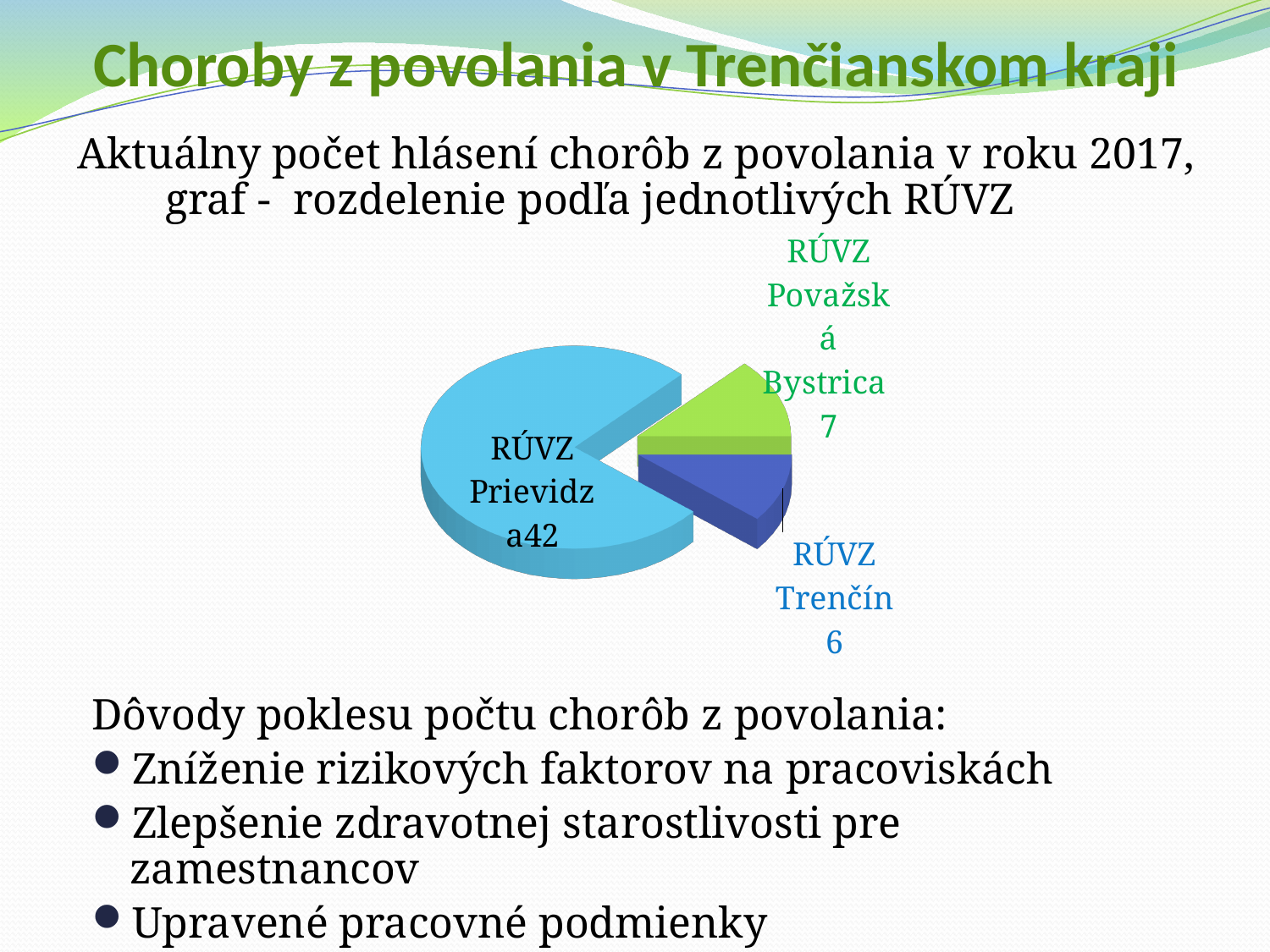
What is the difference between the values for RÚVZ Prievidza and RÚVZ Považská Bystrica? 35 How many slices does the pie chart have? 3 What type of chart is shown on the slide? pie chart What colour is the slice for RÚVZ Prievidza? light blue What is the difference between the values for RÚVZ Považská Bystrica and RÚVZ Trenčín? 1 What is the value for RÚVZ Prievidza in the pie chart? 42 What is the total of all three values in the pie chart? 55 What is the value for RÚVZ Trenčín in the pie chart? 6 Which is larger, the value for RÚVZ Prievidza or the value for RÚVZ Trenčín? RÚVZ Prievidza Which RÚVZ has the largest slice in the pie chart? RÚVZ Prievidza What is the value for RÚVZ Považská Bystrica in the pie chart? 7 Which RÚVZ has the smallest slice in the pie chart? RÚVZ Trenčín